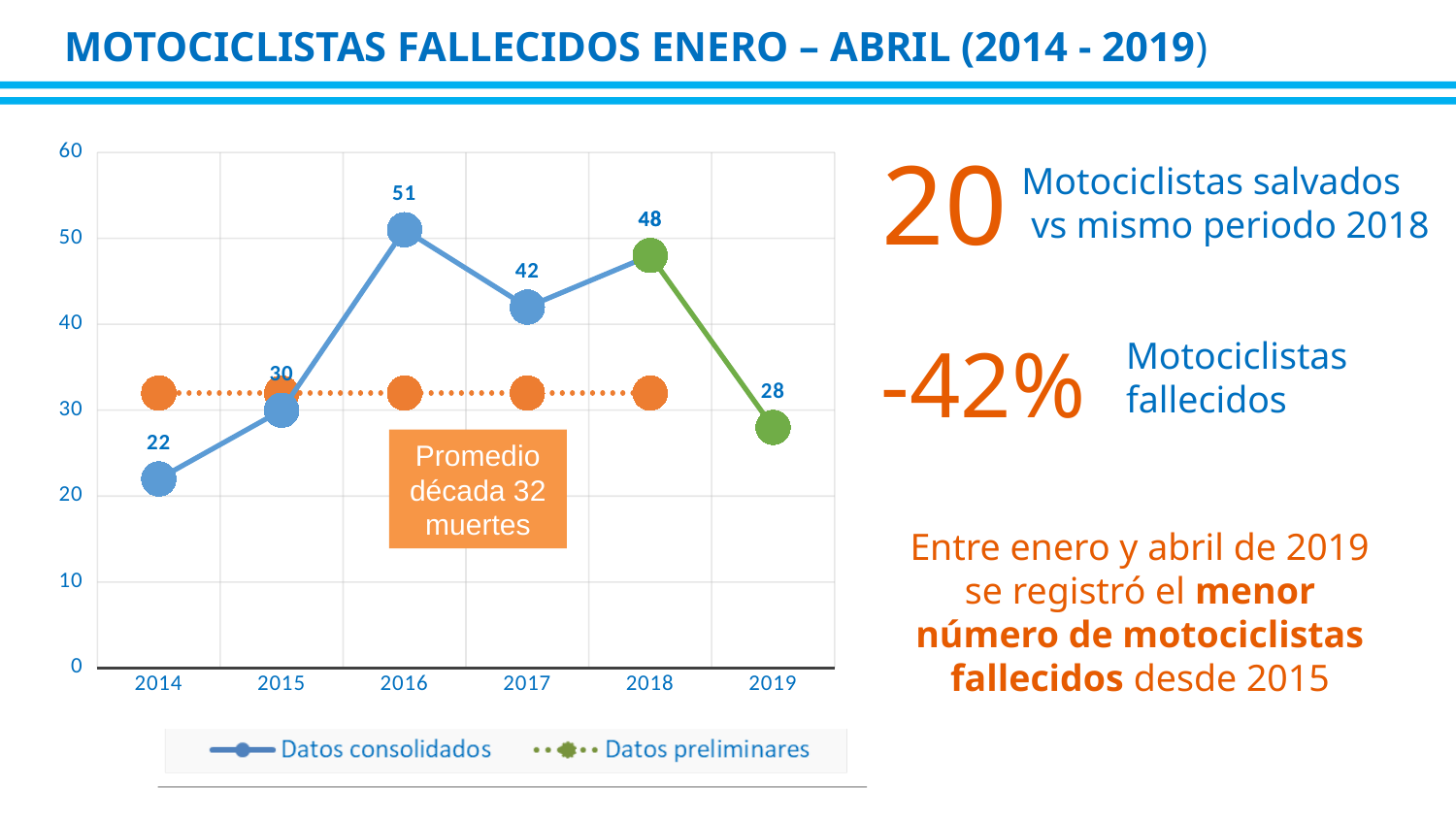
Which year has the lowest value on the chart? 2014 Which year has the highest value on the chart? 2016 Is the value for 2018 greater or less than 40? greater What is the number of motorcyclist deaths shown for 2016? 51 What value is plotted for 2019? 28 What is the difference between the values for 2018 and 2019? 20 What is the difference between the values for 2016 and 2017? 9 How many series does the legend list? 2 How many years are shown on the x axis? 6 What type of chart is shown on the slide? Line chart What value is plotted for 2014? 22 Which year has a larger value, 2015 or 2017? 2017